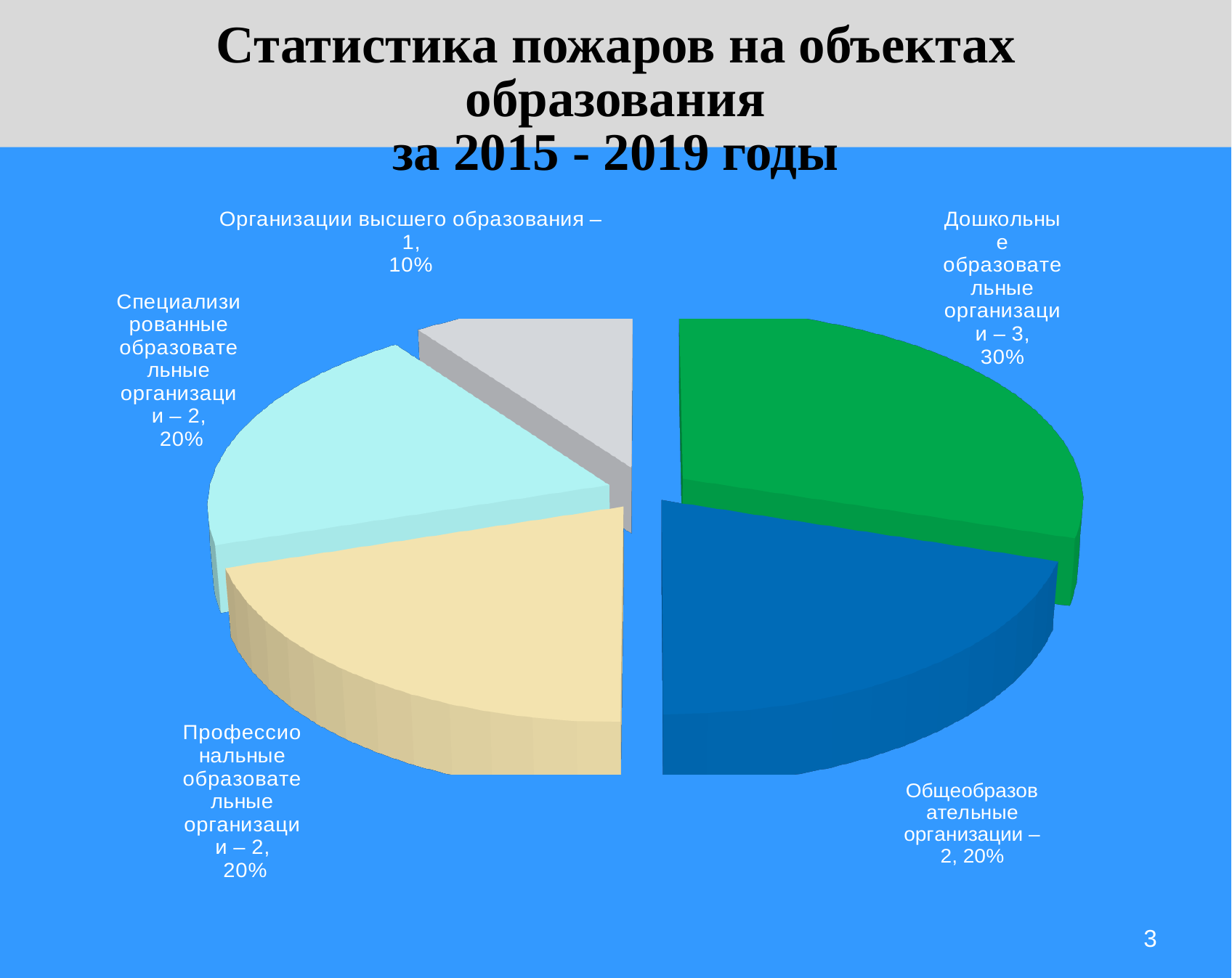
Which category has the largest slice of the pie? Дошкольные образовательные организации What kind of chart is shown on the slide? Pie chart How many slices does the pie chart have? 5 What is the value for Организации высшего образования? 1 Which is larger: the value for Общеобразовательные организации or the value for Организации высшего образования? Общеобразовательные организации What share of the pie does Организации высшего образования take? 10% What share of the pie does Профессиональные образовательные организации take? 20% What share of the pie does Дошкольные образовательные организации take? 30% Which category has the smallest slice of the pie? Организации высшего образования What is the title of the slide containing the chart? Статистика пожаров на объектах образования за 2015 - 2019 годы What is the value for Дошкольные образовательные организации? 3 What is the difference between the values for Дошкольные образовательные организации and Организации высшего образования? 2